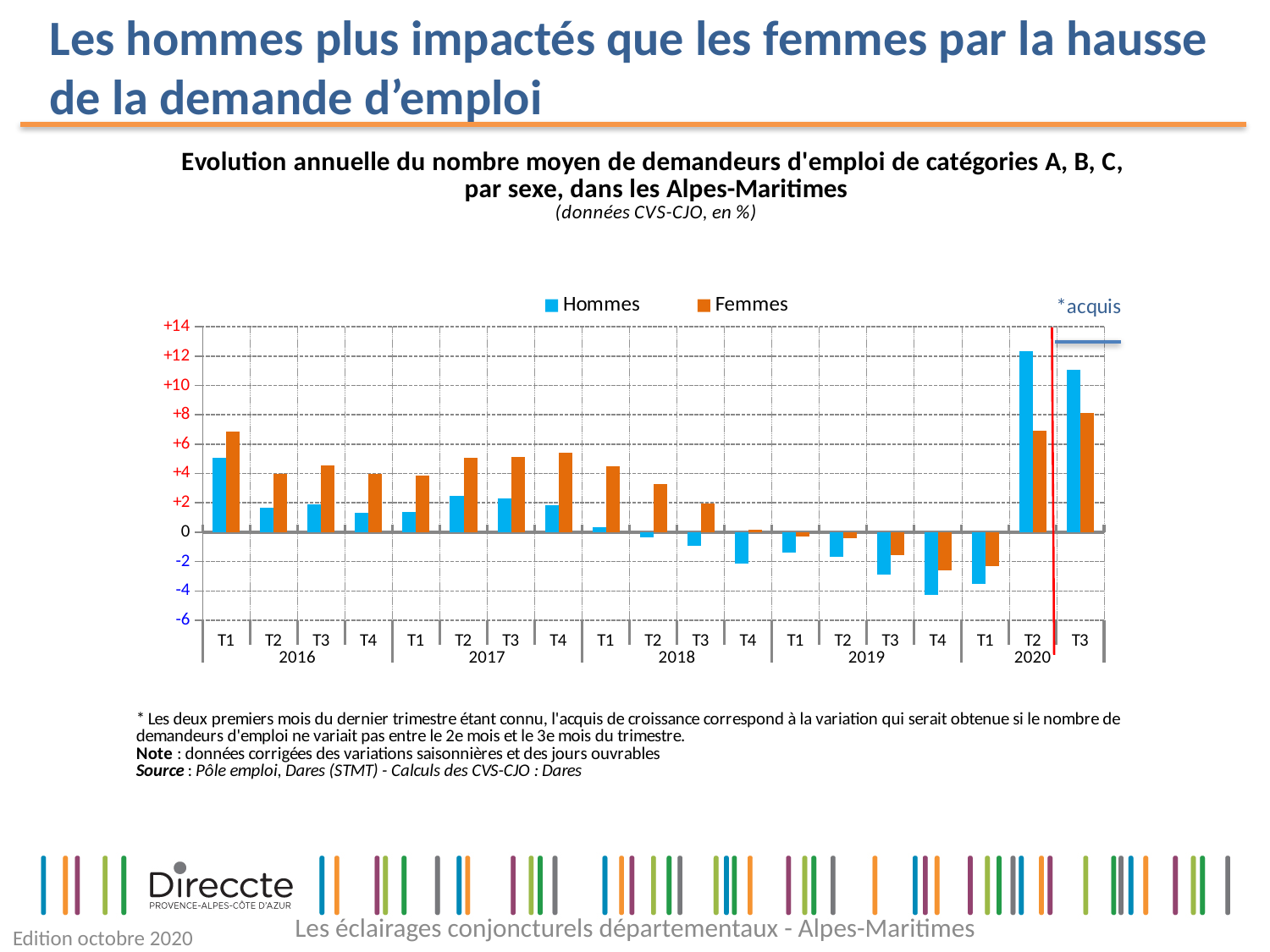
In T1 2016, which series has the larger value, Hommes or Femmes? Femmes In T2 2020, which series has the larger value, Hommes or Femmes? Hommes Is the Hommes value for T4 2019 greater or less than -4? less In which quarter is the Hommes value highest? T2 2020 In which quarter is the Femmes value highest? T3 2020 How many series does the legend list? 2 Is the Femmes value for T1 2016 greater or less than +6? greater What are the two series named in the legend? Hommes and Femmes Is the Hommes value for T2 2020 greater or less than +10? greater In which quarter is the Hommes value lowest? T4 2019 How many quarters (bar groups) are plotted along the x axis? 19 What kind of chart is shown on the slide? bar chart